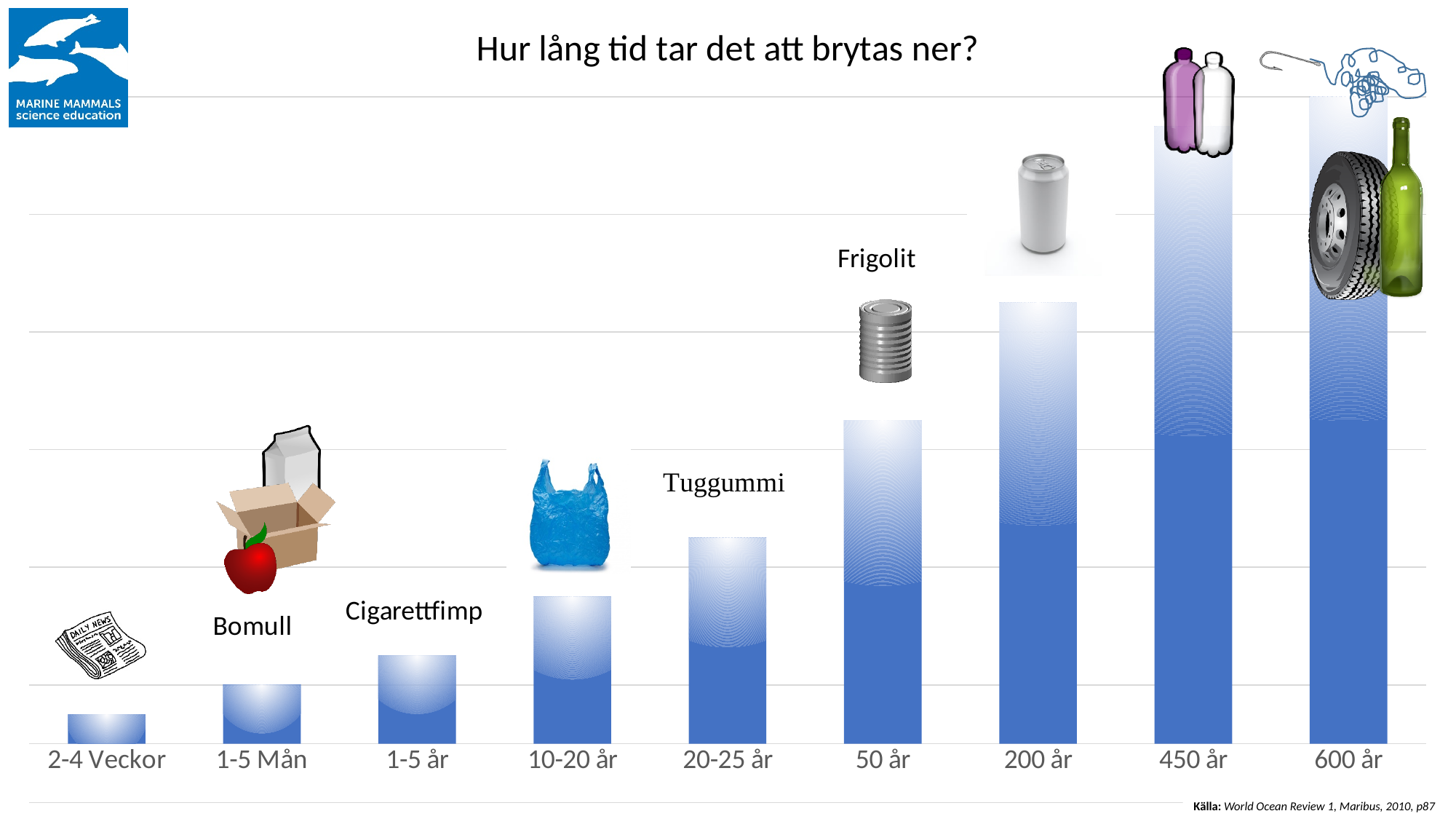
How many bars are plotted in the chart? 9 What kind of chart is shown on the slide? bar chart What is the x-axis label of the bar immediately to the right of the 50 år bar? 200 år Which bar is taller, the one for 200 år or the one for 450 år? 450 år Do the bars rise or fall from left to right along the x axis? rise Which bar is shorter, the one for 1-5 Mån or the one for 20-25 år? 1-5 Mån Which x-axis category has the tallest bar? 600 år Which x-axis category has the shortest bar? 2-4 Veckor What is the title of the chart? Hur lång tid tar det att brytas ner? Which bar is taller, the one for 1-5 år or the one for 10-20 år? 10-20 år What text label is printed above the bar for 20-25 år? Tuggummi